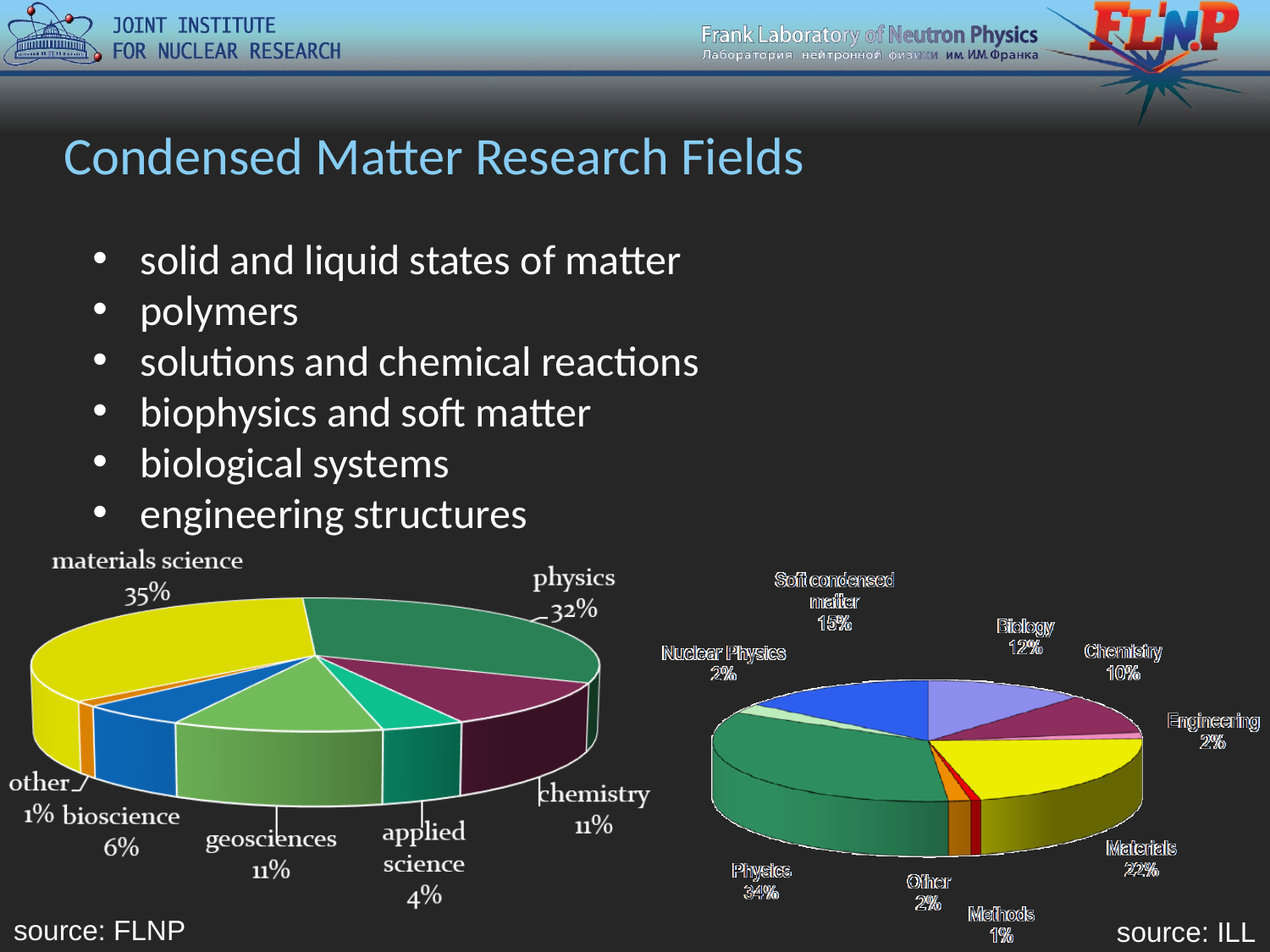
In the left pie chart (source: FLNP), what share does applied science have? 4% In the right pie chart (source: ILL), what share does Soft condensed matter have? 15% How many categories are shown in the left pie chart (source: FLNP)? 7 In the right pie chart (source: ILL), what share does Materials have? 22% In the left pie chart (source: FLNP), what is the difference between the shares of materials science and physics? 3% In the left pie chart (source: FLNP), what share does materials science have? 35% What type of chart is used on the right side of the slide (source: ILL)? pie chart In the right pie chart (source: ILL), which is larger: Biology or Chemistry? Biology In the right pie chart (source: ILL), which category has the smallest share? Methods In the left pie chart (source: FLNP), which category has the smallest share? other In the left pie chart (source: FLNP), which category has the largest share? materials science In the right pie chart (source: ILL), which category has the largest share? Physics